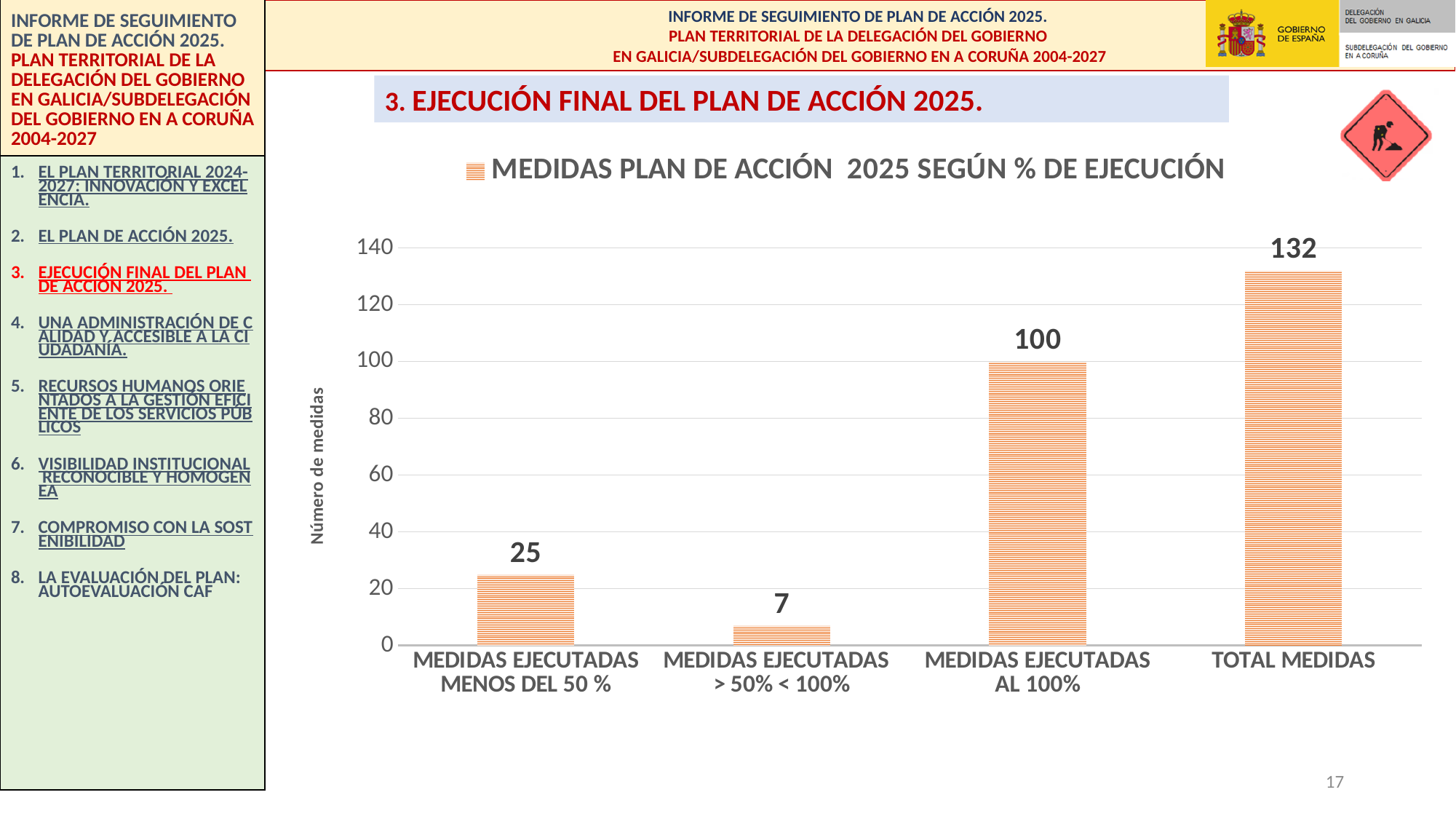
Which category has the lowest value? MEDIDAS EJECUTADAS > 50% < 100% What is the value for MEDIDAS EJECUTADAS MENOS DEL 50 %? 25 What is the label of the vertical axis? Número de medidas What is the value for MEDIDAS EJECUTADAS > 50% < 100%? 7 Which category has the highest value? TOTAL MEDIDAS Which is larger, MEDIDAS EJECUTADAS MENOS DEL 50 % or MEDIDAS EJECUTADAS > 50% < 100%? MEDIDAS EJECUTADAS MENOS DEL 50 % How many categories are shown on the x axis? 4 What is the value for TOTAL MEDIDAS? 132 What is the difference between TOTAL MEDIDAS and MEDIDAS EJECUTADAS AL 100%? 32 What is the value for MEDIDAS EJECUTADAS AL 100%? 100 Is the value for MEDIDAS EJECUTADAS AL 100% greater or less than 80? greater What kind of chart is shown on the slide? bar chart